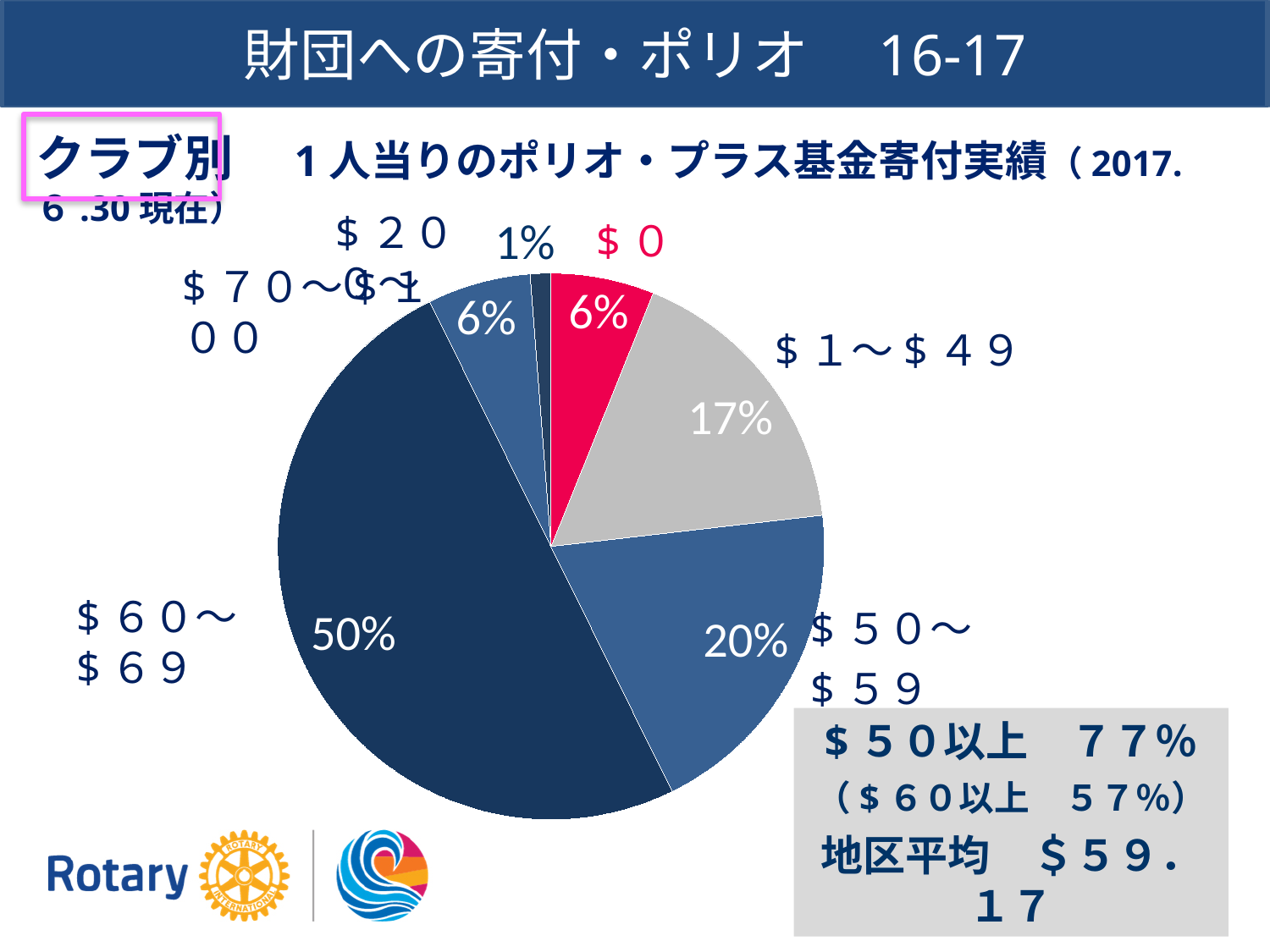
Which is larger, the share for $50～$59 or the share for $1～$49? $50～$59 What share of the pie does the $0 category have? 6% What share of the pie does the $1～$49 category have? 17% What kind of chart is shown on the slide? pie chart How many slices does the pie chart have? 6 What is the smallest percentage shown on any slice of the pie chart? 1% What share of the pie does the $60～$69 category have? 50% Which category has the largest share of the pie chart? $60～$69 What is the difference in percentage points between the $60～$69 slice and the $50～$59 slice? 30 What is the combined share of the $1～$49 and $0 slices? 23% What colour is the $0 slice of the pie chart? red